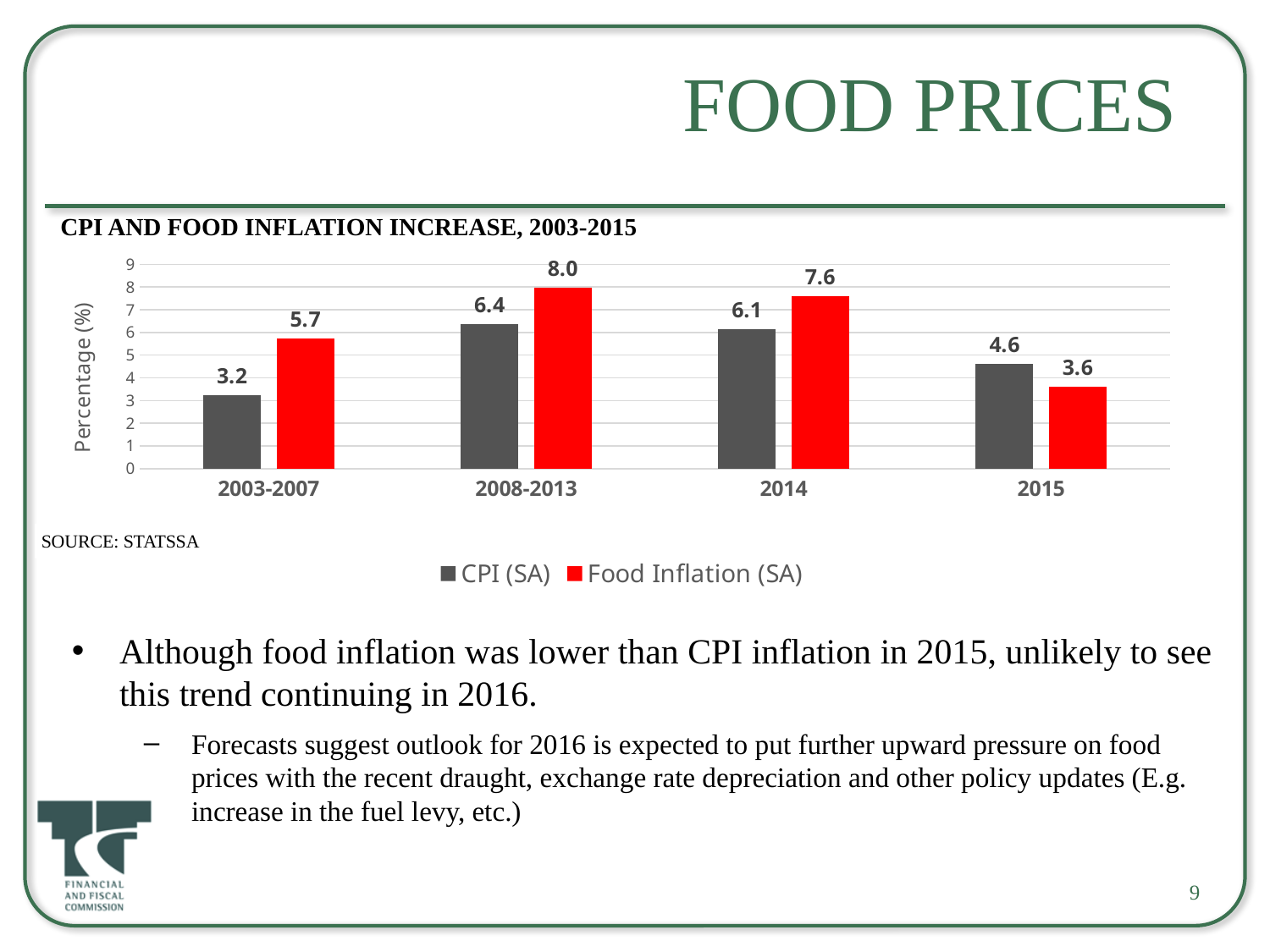
How many series does the legend list? 2 What is the CPI (SA) value for 2003-2007? 3.2 Which period has the highest Food Inflation (SA) value? 2008-2013 Which period has the lowest CPI (SA) value? 2003-2007 What is the Food Inflation (SA) value for 2008-2013? 8.0 What kind of chart is shown on the slide? Bar chart What is the title of the chart? CPI AND FOOD INFLATION INCREASE, 2003-2015 In 2015, which is larger: CPI (SA) or Food Inflation (SA)? CPI (SA) How many periods are shown on the x axis? 4 Is the Food Inflation (SA) value for 2003-2007 greater or less than 5? greater What is the difference between Food Inflation (SA) and CPI (SA) in 2014? 1.5 What is the Food Inflation (SA) value for 2015? 3.6